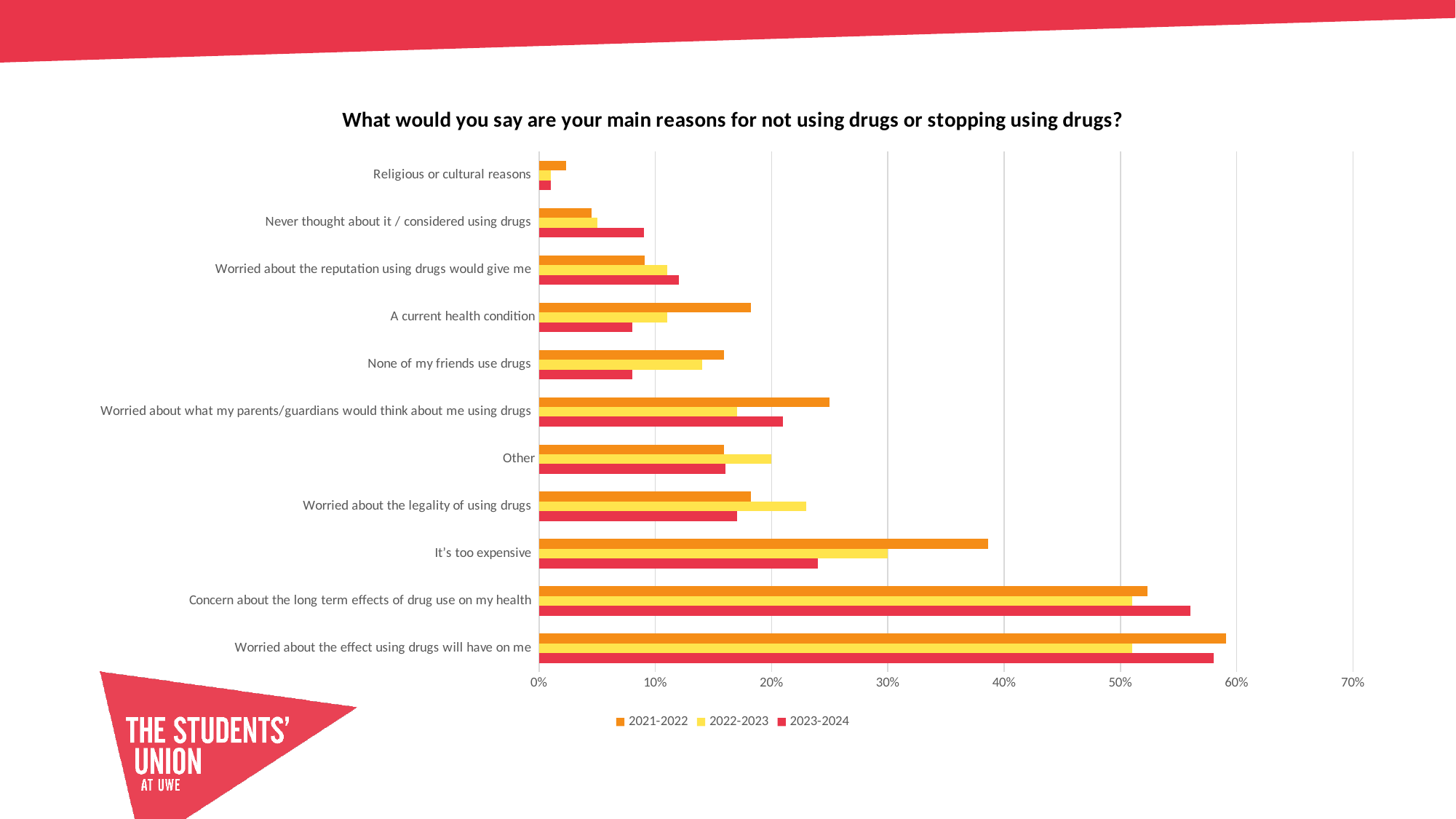
What kind of chart is shown on the slide? Bar chart Which category has the lowest value for the 2023-2024 series? Religious or cultural reasons What are the three series listed in the legend? 2021-2022, 2022-2023, 2023-2024 Is the 2021-2022 value for 'Worried about what my parents/guardians would think about me using drugs' greater or less than 20%? greater Which category has the highest value for the 2021-2022 series? Worried about the effect using drugs will have on me Is the 2023-2024 value for 'Concern about the long term effects of drug use on my health' greater or less than 50%? greater For 'Worried about the legality of using drugs', which series has the larger value: 2021-2022 or 2022-2023? 2022-2023 Which category has the lowest value for the 2021-2022 series? Religious or cultural reasons How many reason categories are plotted on the chart? 11 Is the 2021-2022 value for 'It's too expensive' greater or less than 30%? greater For 'A current health condition', which series has the larger value: 2021-2022 or 2023-2024? 2021-2022 How many series does the legend list? 3